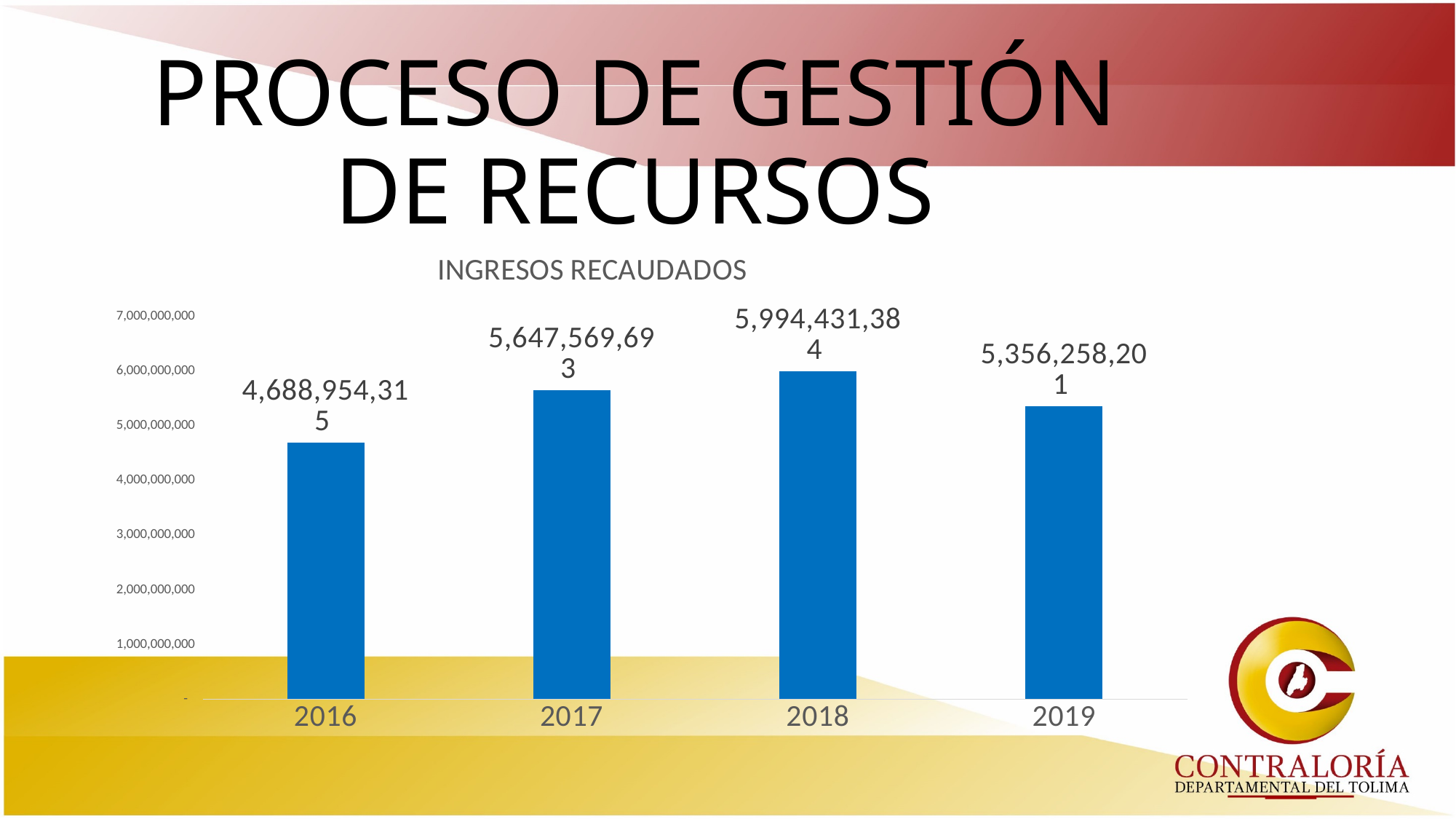
What is the value for 2018 in the INGRESOS RECAUDADOS chart? 5,994,431,384 Is the value for 2016 greater or less than 5,000,000,000 in the INGRESOS RECAUDADOS chart? less Which year has the highest value in the INGRESOS RECAUDADOS chart? 2018 What kind of chart is the INGRESOS RECAUDADOS chart? bar chart What is the value for 2016 in the INGRESOS RECAUDADOS chart? 4,688,954,315 What is the difference between the values for 2018 and 2017 in the INGRESOS RECAUDADOS chart? 346,861,691 What is the value for 2019 in the INGRESOS RECAUDADOS chart? 5,356,258,201 What is the title of the chart on the slide? INGRESOS RECAUDADOS Which year has the larger value in the INGRESOS RECAUDADOS chart, 2017 or 2019? 2017 Which year has the lowest value in the INGRESOS RECAUDADOS chart? 2016 How many years are shown in the INGRESOS RECAUDADOS chart? 4 What is the difference between the values for 2017 and 2016 in the INGRESOS RECAUDADOS chart? 958,615,378